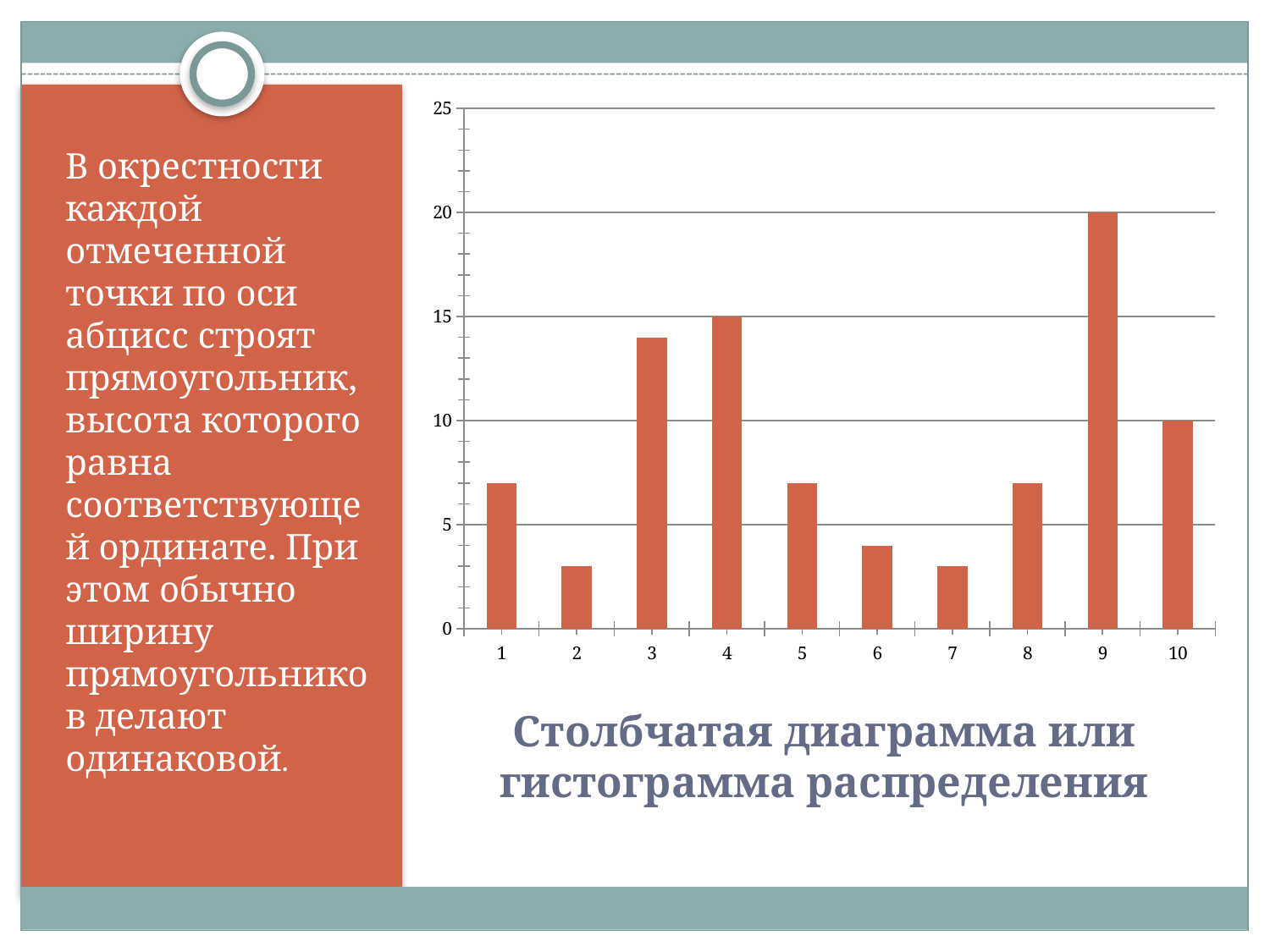
Which is larger, the value for category 1 or the value for category 6? category 1 Which category has the highest bar in the chart? 9 What kind of chart is shown on the slide? bar chart What is the value for category 9? 20 What is the value for category 10? 10 Is the value for category 3 greater or less than 10? greater What caption is written below the chart? Столбчатая диаграмма или гистограмма распределения What is the difference between the values for category 9 and category 4? 5 What is the value for category 4? 15 How many categories are shown on the x axis of the chart? 10 What is the difference between the values for category 9 and category 10? 10 Is the value for category 7 greater or less than 5? less